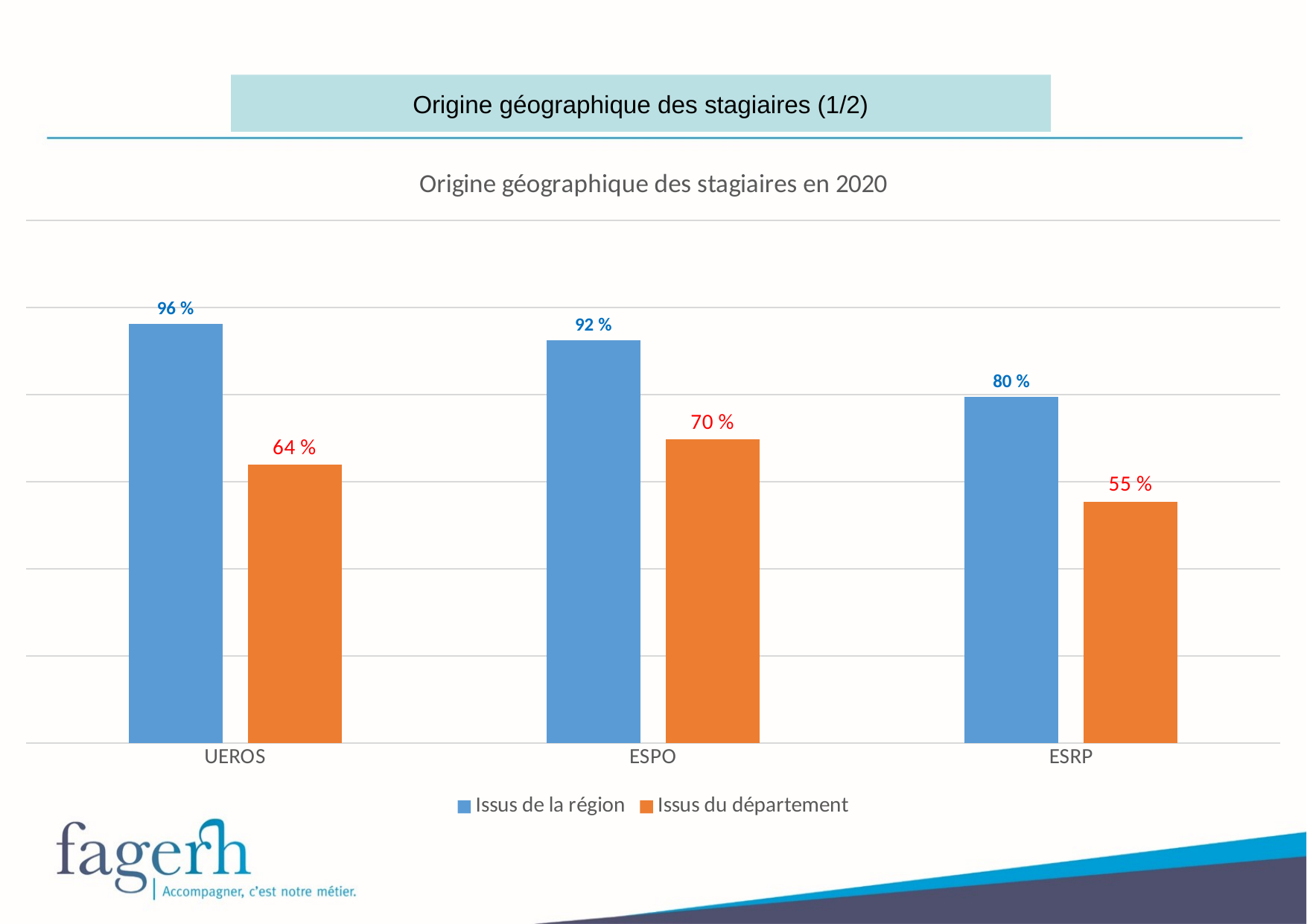
How many categories are shown on the x axis? 3 What kind of chart is shown on the slide? Bar chart What is the difference between the 'Issus de la région' values for ESPO and ESRP? 12 % Which category has the lowest value for 'Issus du département'? ESRP What is the value for 'Issus du département' for ESRP? 55 % What is the value for 'Issus de la région' for UEROS? 96 % What is the difference between 'Issus de la région' and 'Issus du département' for UEROS? 32 % What is the title of the chart? Origine géographique des stagiaires en 2020 What is the value for 'Issus du département' for ESPO? 70 % Which is larger: 'Issus du département' for UEROS or for ESPO? ESPO How many series does the legend list? 2 Which category has the highest value for 'Issus de la région'? UEROS